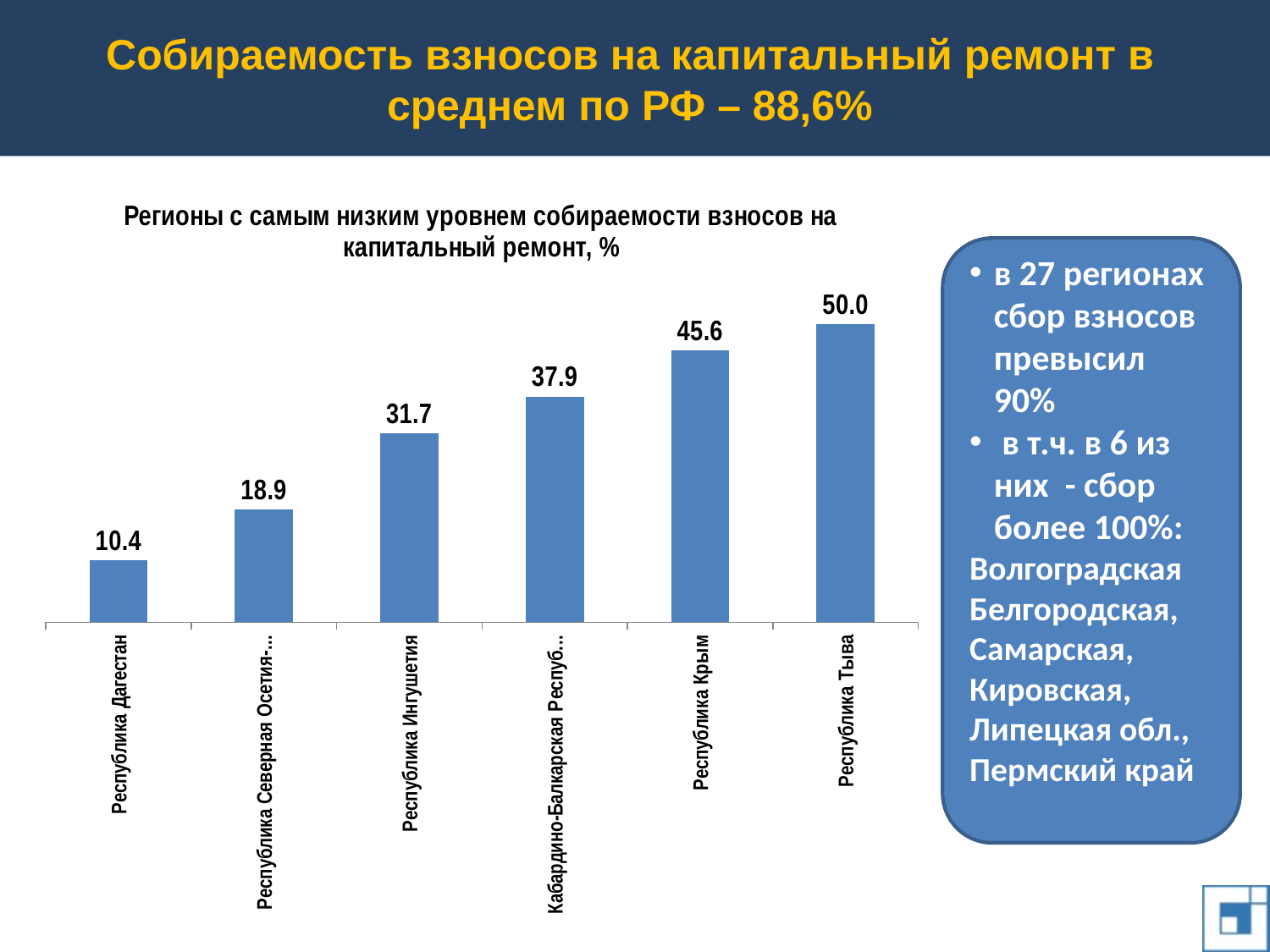
What is the value for Республика Тыва? 50.0 Which region has the highest value on the chart? Республика Тыва Which is larger, the value for Республика Северная Осетия or the value for Республика Ингушетия? Республика Ингушетия What is the value for Республика Крым? 45.6 What kind of chart is shown on the slide? Bar chart Which region has the lowest value on the chart? Республика Дагестан What is the difference between the values for Республика Тыва and Республика Дагестан? 39.6 What is the value for Республика Дагестан? 10.4 How many regions are shown on the chart? 6 What is the value for Республика Ингушетия? 31.7 What is the difference between the values for Республика Крым and Кабардино-Балкарская Республика? 7.7 Do the values rise or fall from left to right across the chart? Rise